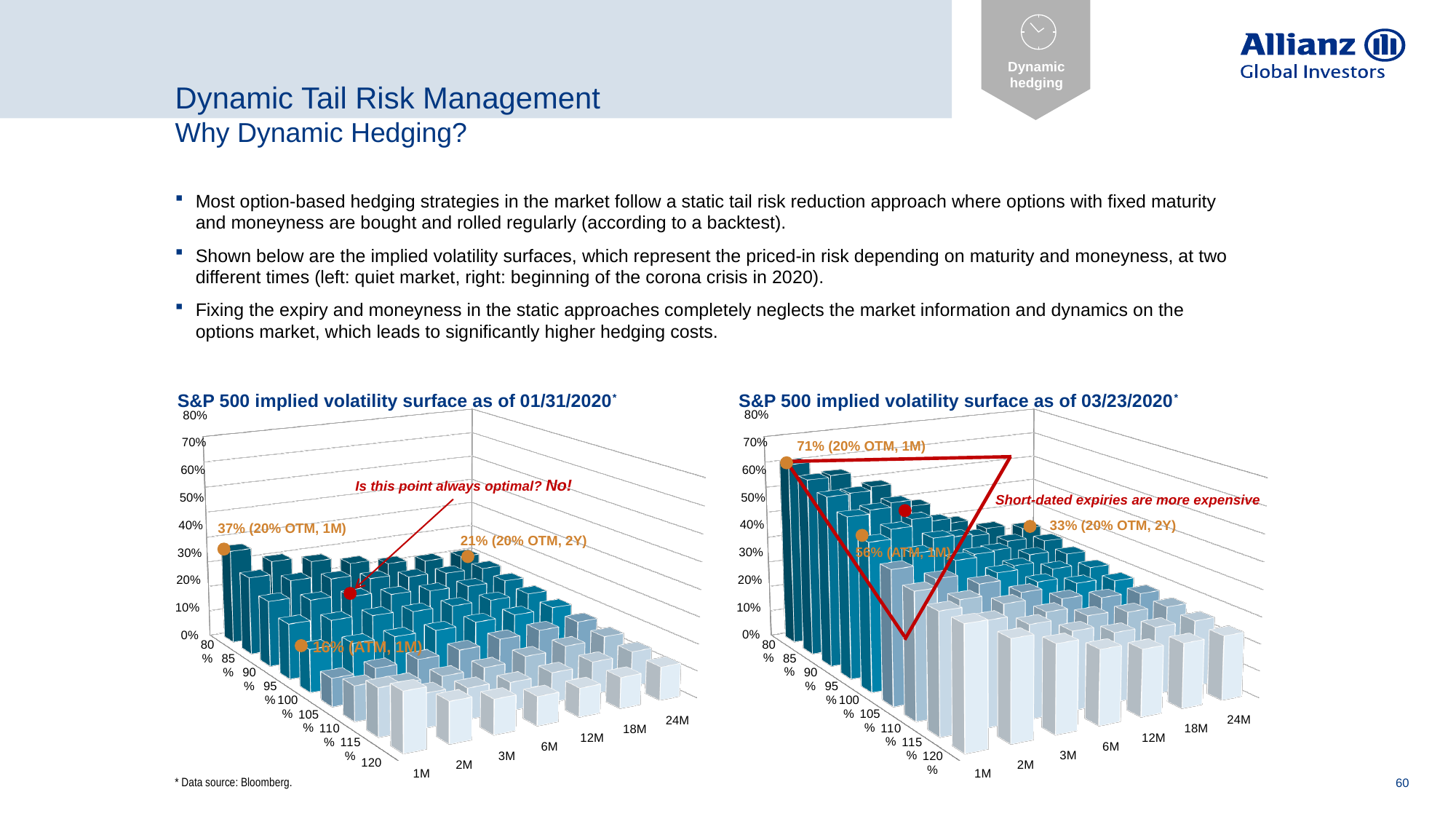
In the left chart (as of 01/31/2020), what is the difference between the labelled values for 20% OTM, 1M and 20% OTM, 2Y? 16 percentage points In the left chart (as of 01/31/2020), what is the implied volatility labelled for 20% OTM, 2Y? 21% In the right chart (S&P 500 implied volatility surface as of 03/23/2020), what is the implied volatility labelled for 20% OTM, 1M? 71% How many maturity categories (1M to 24M) are shown along the front axis of the left chart? 7 In the left chart (S&P 500 implied volatility surface as of 01/31/2020), what is the implied volatility labelled for 20% OTM, 1M? 37% How many moneyness categories (80% to 120%) are shown along the side axis of the right chart? 9 In the left chart (as of 01/31/2020), is the value for 20% OTM, 1M greater or less than 50%? less In the right chart (as of 03/23/2020), what is the difference between the labelled values for 20% OTM, 1M and 20% OTM, 2Y? 38 percentage points What kind of chart is used for the S&P 500 implied volatility surfaces on this slide? 3D bar chart Which chart shows the higher labelled implied volatility for 20% OTM, 1M: the left chart (01/31/2020) or the right chart (03/23/2020)? The right chart (03/23/2020) In the left chart (as of 01/31/2020), what is the implied volatility labelled for ATM, 1M? 16% In the right chart (as of 03/23/2020), what is the implied volatility labelled for 20% OTM, 2Y? 33%